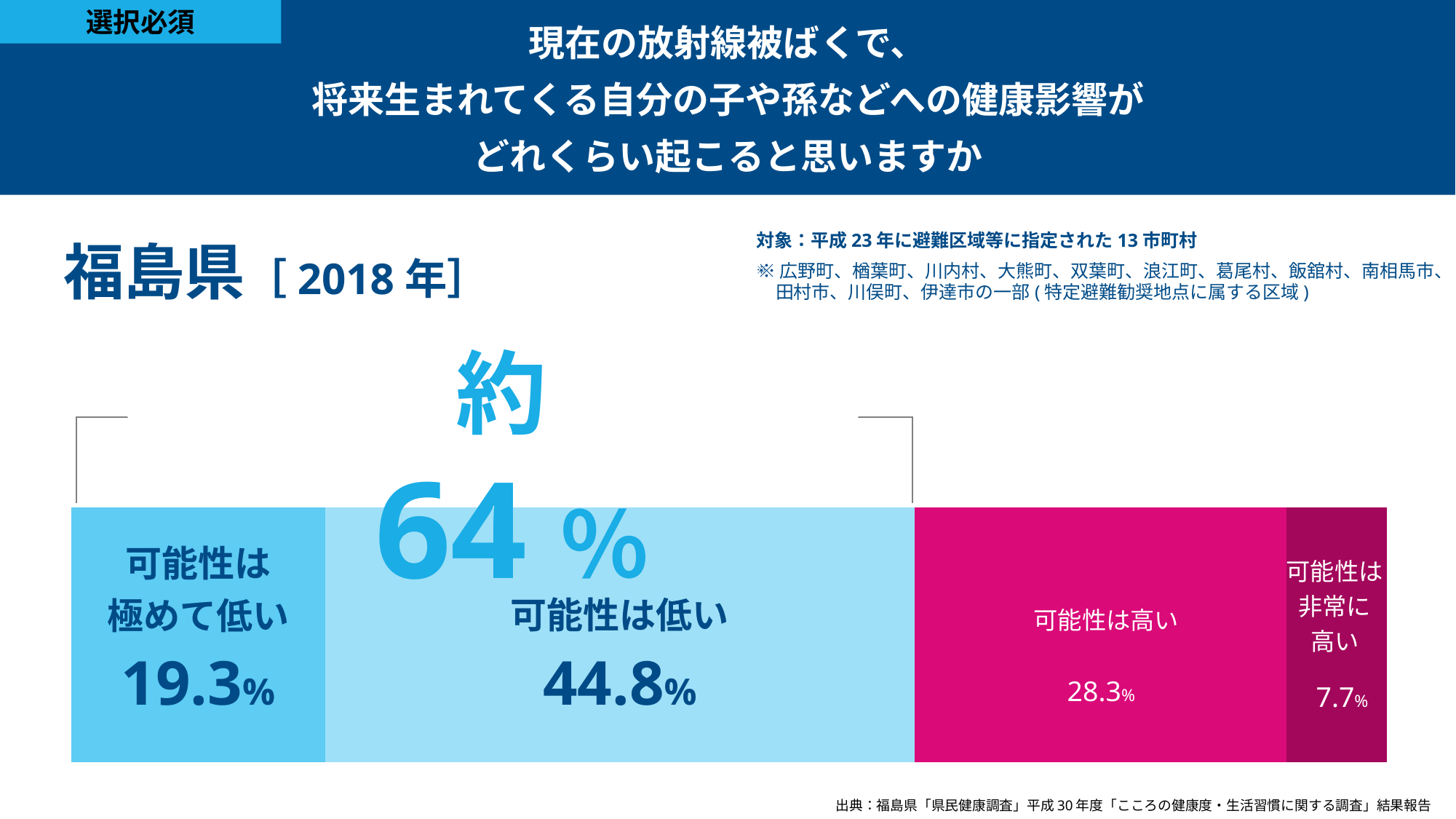
What percentage of respondents answered 「可能性は高い」? 28.3% Which response category has the smallest share? 可能性は非常に高い What percentage of respondents answered 「可能性は非常に高い」? 7.7% What kind of chart is shown on the slide? Stacked bar chart Which is larger, the share for 「可能性は極めて低い」 or the share for 「可能性は高い」? 可能性は高い What percentage of respondents answered 「可能性は極めて低い」? 19.3% What percentage of respondents answered 「可能性は低い」? 44.8% What combined percentage is highlighted above the two 'low possibility' segments (可能性は極めて低い and 可能性は低い)? 約64% Which response category has the largest share? 可能性は低い What is the difference in percentage points between 「可能性は低い」 and 「可能性は高い」? 16.5 Which year does the chart for 福島県 refer to? 2018年 How many response categories are shown in the bar? 4